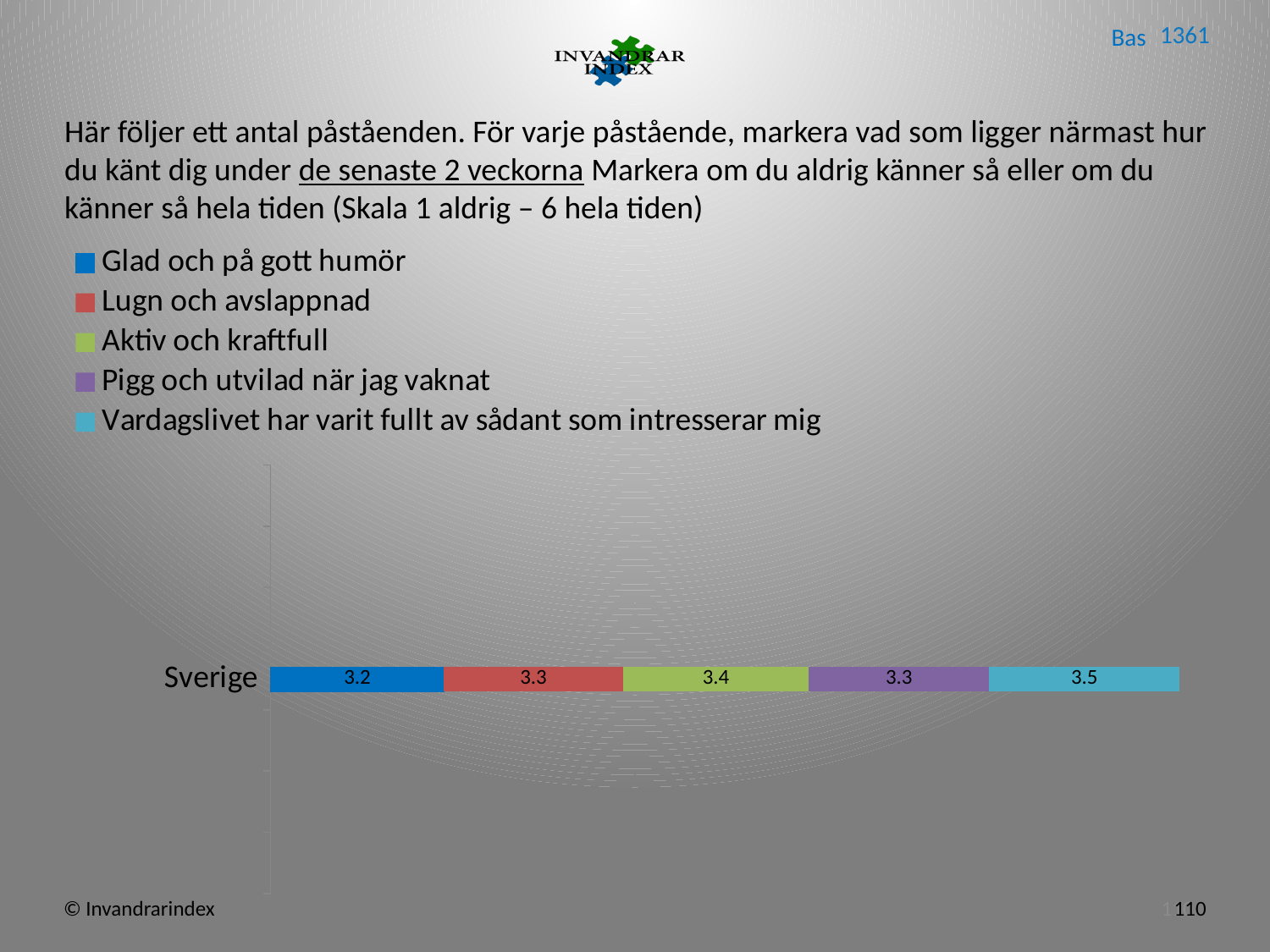
What is the value for "Lugn och avslappnad" for Sverige? 3.3 What kind of chart is shown on the slide? Stacked bar chart What is the value for "Vardagslivet har varit fullt av sådant som intresserar mig" for Sverige? 3.5 What is the difference between the values for "Vardagslivet har varit fullt av sådant som intresserar mig" and "Glad och på gott humör"? 0.3 Which series has the lowest value for Sverige? Glad och på gott humör What is the value for "Glad och på gott humör" for Sverige? 3.2 What is the total of the stacked bar for Sverige? 16.7 Which series has the highest value for Sverige? Vardagslivet har varit fullt av sådant som intresserar mig Which is larger for Sverige: "Aktiv och kraftfull" or "Lugn och avslappnad"? Aktiv och kraftfull How many series does the legend list? 5 What is the value for "Aktiv och kraftfull" for Sverige? 3.4 What is the value for "Pigg och utvilad när jag vaknat" for Sverige? 3.3